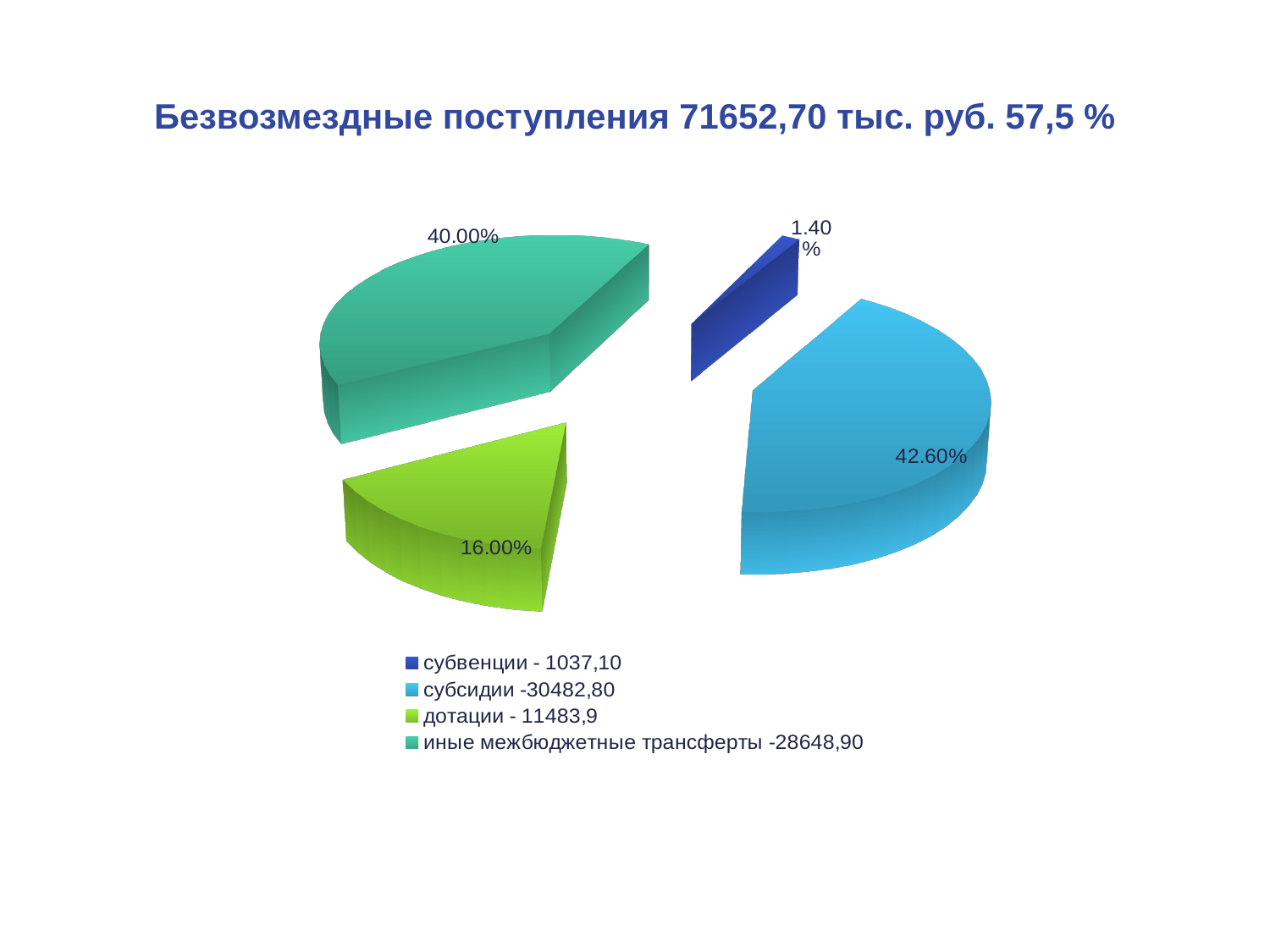
Which has a larger share: дотации or иные межбюджетные трансферты? иные межбюджетные трансферты Which category has the largest slice of the pie? субсидии What percentage share is shown for иные межбюджетные трансферты? 40.00% How many slices does the pie chart have? 4 What percentage share is shown for субсидии? 42.60% What value is listed in the legend for субсидии? 30482,80 What is the difference in percentage points between the shares of субсидии and иные межбюджетные трансферты? 2.60% What percentage share is shown for субвенции? 1.40% Which category has the smallest slice of the pie? субвенции What is the title of the chart? Безвозмездные поступления 71652,70 тыс. руб. 57,5 % What kind of chart is shown on the slide? pie chart